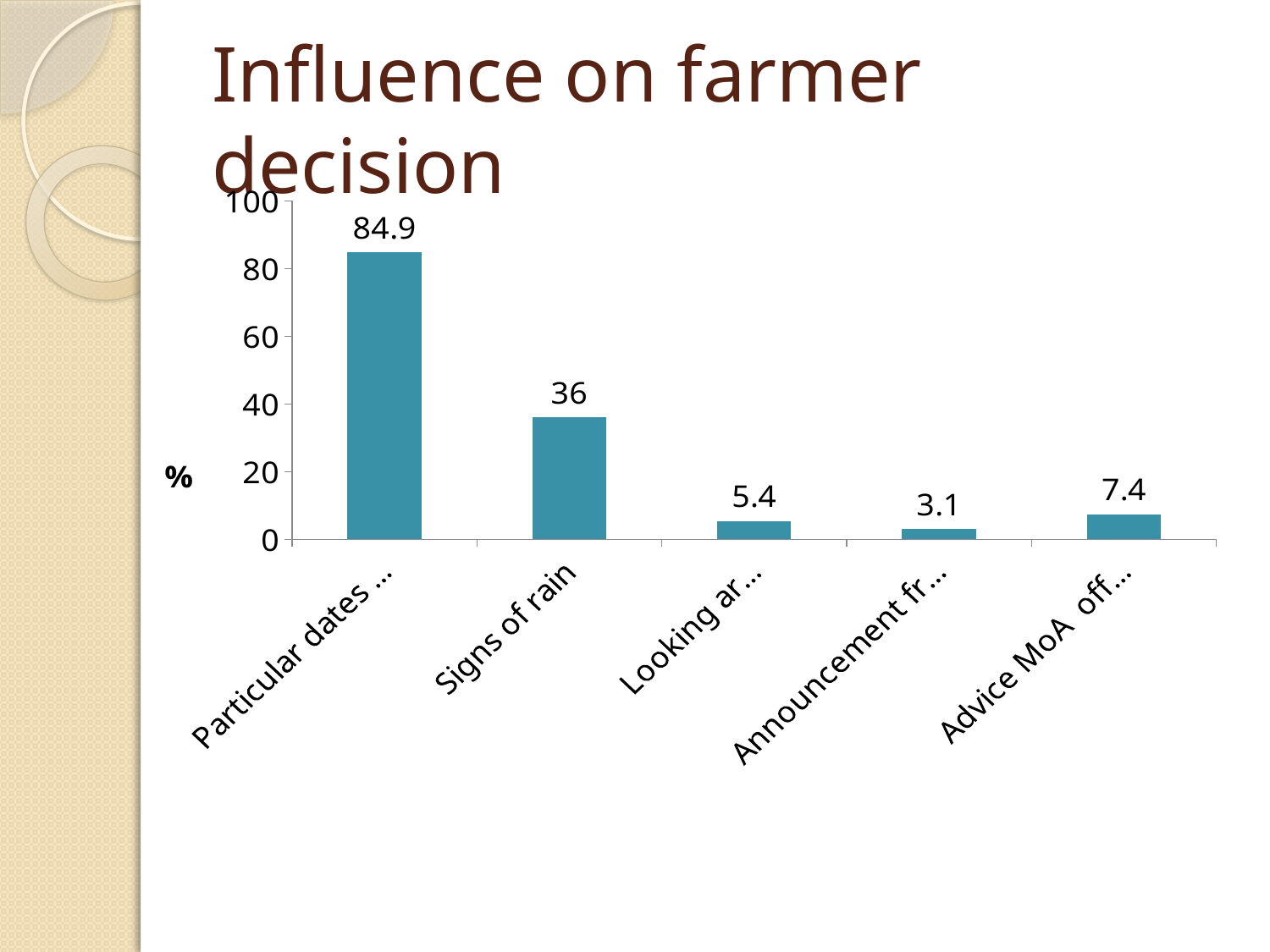
What is the value of the last bar, labelled "Advice MoA off..."? 7.4 Which category has the lowest value? Announcement fr... What is the label on the vertical axis? % Which category has the highest value? Particular dates ... Which is larger, the value for "Looking ar..." or the value for "Advice MoA off..."? Advice MoA off... What is the value of the first bar, labelled "Particular dates ..."? 84.9 Is the value for Signs of rain greater or less than 40? less How many bars are shown in the chart? 5 What is the value of the fourth bar, labelled "Announcement fr..."? 3.1 What kind of chart is shown on the slide? bar chart What is the difference between the value for "Particular dates ..." and the value for Signs of rain? 48.9 What is the value for Signs of rain? 36